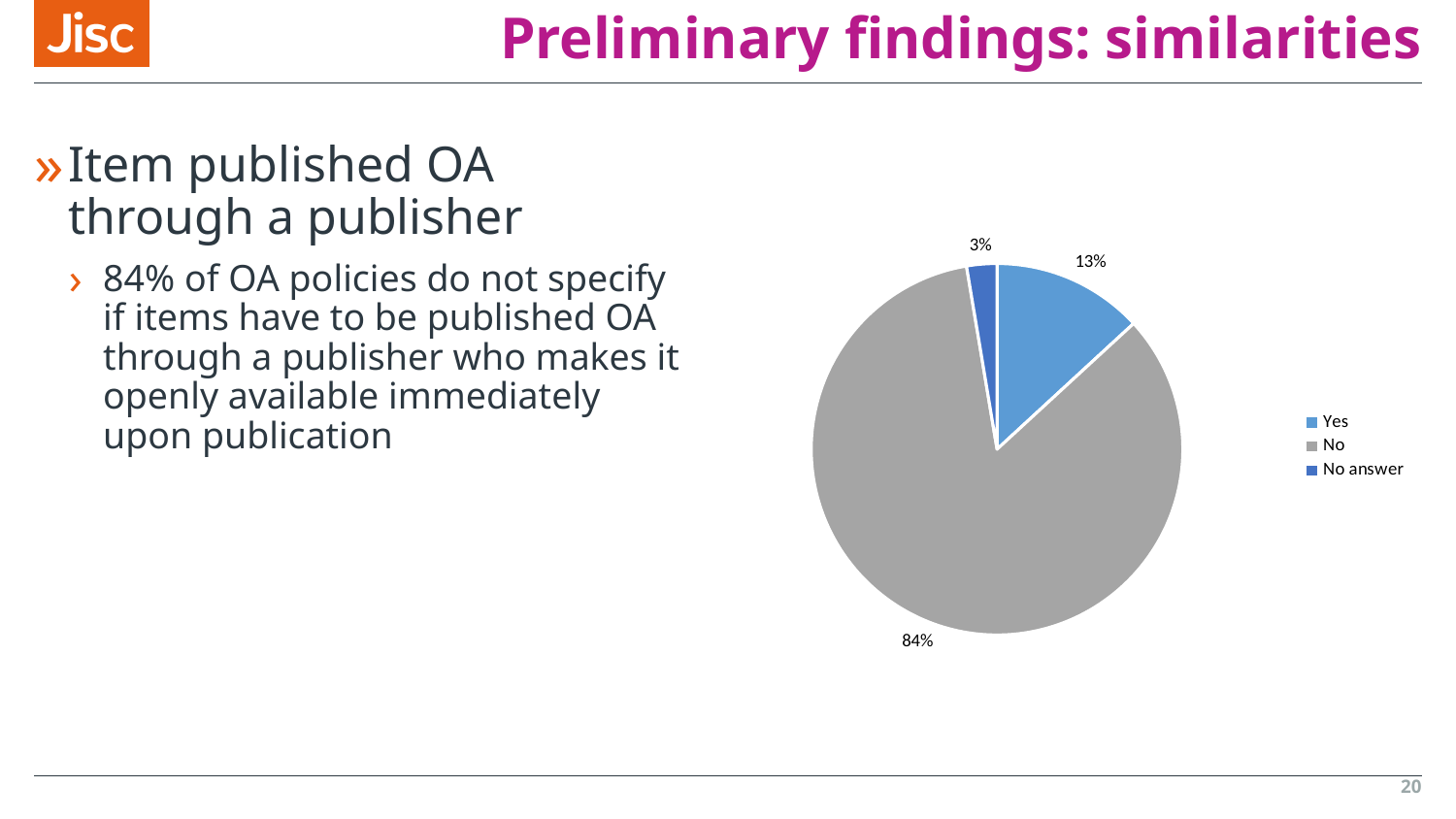
What share of the pie does the "No" slice represent? 84% Which category has the largest slice of the pie? No What share of the pie does the "Yes" slice represent? 13% What is the difference in percentage points between the "No" slice and the "Yes" slice? 71 What is the difference in percentage points between the "Yes" slice and the "No answer" slice? 10 Which category has the smallest slice of the pie? No answer Which is larger, the "Yes" slice or the "No answer" slice? Yes What kind of chart is shown on the slide? pie chart How many entries does the legend list? 3 How many slices does the pie chart have? 3 What colour is the "No" slice in the pie chart? grey What share of the pie does the "No answer" slice represent? 3%